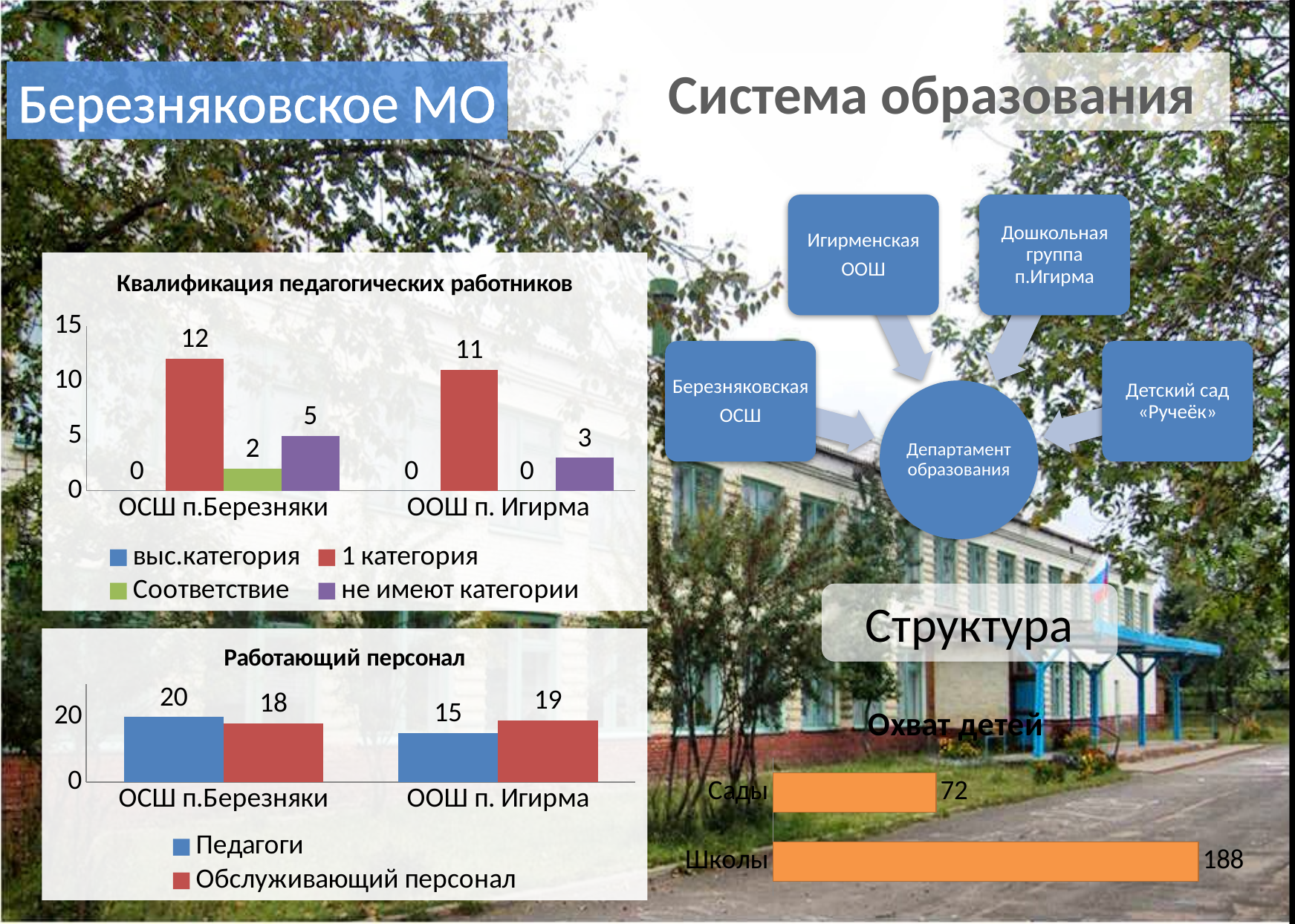
In the chart 'Квалификация педагогических работников', what is the difference between the '1 категория' values for ОСШ п.Березняки and ООШ п. Игирма? 1 What kind of chart is 'Охват детей'? bar chart In the chart 'Квалификация педагогических работников', what is the value for 'Соответствие' at ОСШ п.Березняки? 2 In the chart 'Охват детей', what is the value for 'Школы'? 188 In the chart 'Работающий персонал', which is larger at ООШ п. Игирма: 'Педагоги' or 'Обслуживающий персонал'? Обслуживающий персонал In the chart 'Работающий персонал', what is the difference between 'Педагоги' at ОСШ п.Березняки and 'Педагоги' at ООШ п. Игирма? 5 In the chart 'Квалификация педагогических работников', what is the value for 'не имеют категории' at ООШ п. Игирма? 3 In the chart 'Работающий персонал', what is the value for 'Педагоги' at ООШ п. Игирма? 15 In the chart 'Квалификация педагогических работников', how many series does the legend list? 4 In the chart 'Охват детей', what is the difference between 'Школы' and 'Сады'? 116 In the chart 'Работающий персонал', what is the value for 'Обслуживающий персонал' at ОСШ п.Березняки? 18 In the chart 'Квалификация педагогических работников', what is the value for '1 категория' at ОСШ п.Березняки? 12